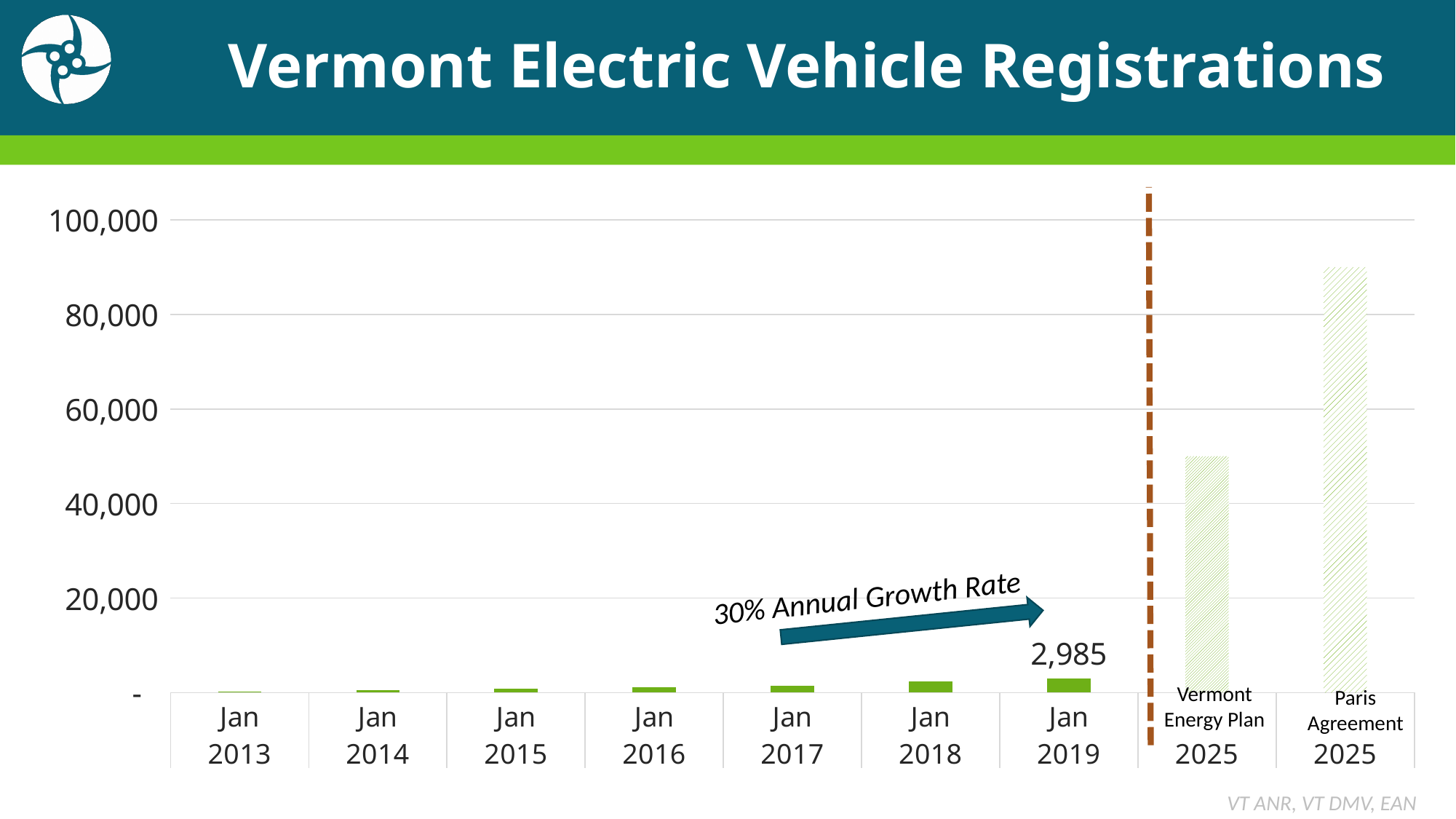
What annual growth rate does the arrow annotation on the chart state? 30% Annual Growth Rate What is the value for Jan 2019? 2,985 Is the value for Paris Agreement 2025 greater or less than 80,000? greater Which category has the highest bar? Paris Agreement 2025 Is the value for Vermont Energy Plan 2025 greater or less than 40,000? greater Which category has the lowest bar? Jan 2013 Do the values rise or fall from Jan 2013 to Jan 2019? rise What kind of chart is shown on the slide? bar chart What is the title of the chart? Vermont Electric Vehicle Registrations Is the value for Paris Agreement 2025 greater or less than 100,000? less How many categories are shown along the x axis? 9 Which is larger, the bar for Vermont Energy Plan 2025 or the bar for Paris Agreement 2025? Paris Agreement 2025